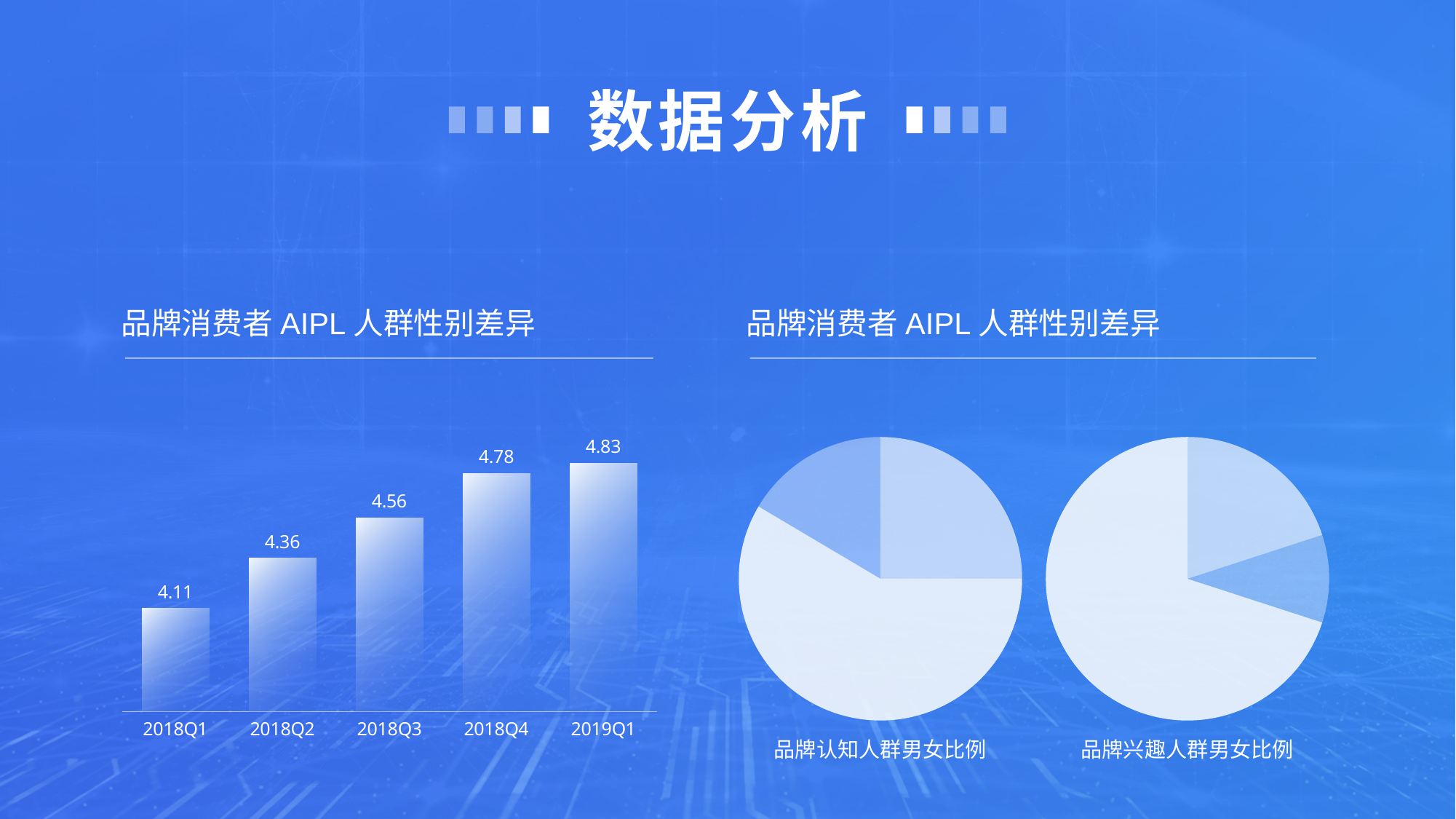
In the bar chart on the left, which quarter has the lowest value? 2018Q1 In the bar chart on the left, what is the difference between the values for 2018Q4 and 2018Q1? 0.67 In the bar chart on the left, which quarter has the highest value? 2019Q1 How many slices does the pie chart labelled 品牌兴趣人群男女比例 have? 3 In the bar chart on the left, do the values rise or fall from 2018Q1 to 2019Q1? Rise In the bar chart on the left, what is the value for 2019Q1? 4.83 What kind of chart is shown on the left side of the slide? Bar chart In the bar chart on the left, what is the value for 2018Q3? 4.56 How many bars are in the bar chart on the left? 5 What is the label under the left pie chart on the right side of the slide? 品牌认知人群男女比例 In the bar chart on the left, which is larger, the value for 2018Q2 or the value for 2018Q3? 2018Q3 What kind of charts are shown on the right side of the slide? Pie charts